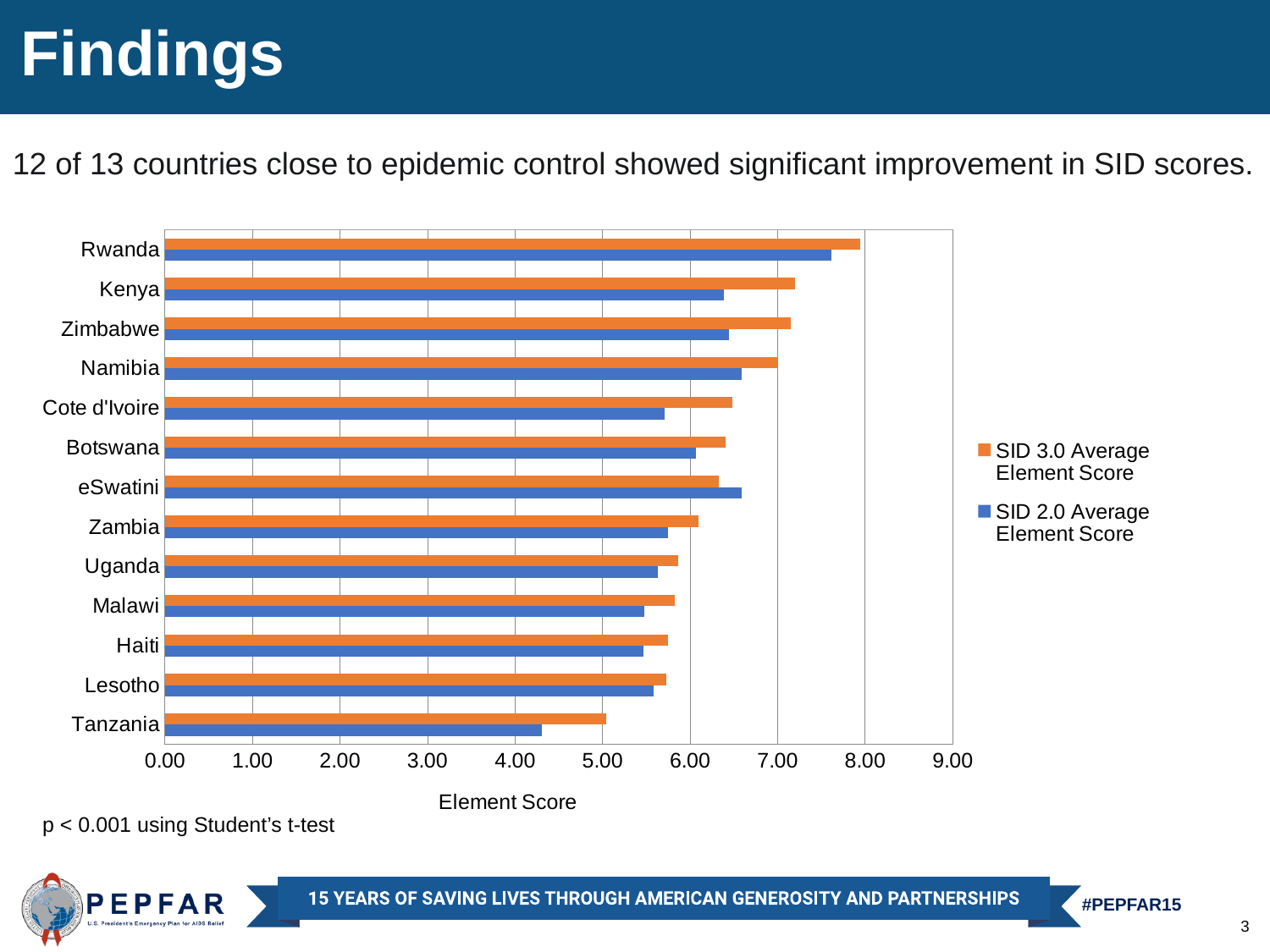
For Kenya, which is larger: the SID 3.0 Average Element Score or the SID 2.0 Average Element Score? SID 3.0 Average Element Score Which country has the lowest SID 2.0 Average Element Score? Tanzania How many countries are listed on the chart? 13 Which country has the lowest SID 3.0 Average Element Score? Tanzania Is the SID 2.0 Average Element Score for Cote d'Ivoire greater or less than 6.00? less How many series does the legend list? 2 Is the SID 3.0 Average Element Score for Rwanda greater or less than 7.00? greater Which country has the highest SID 3.0 Average Element Score? Rwanda Is the SID 2.0 Average Element Score for Tanzania greater or less than 5.00? less For eSwatini, which is larger: the SID 2.0 Average Element Score or the SID 3.0 Average Element Score? SID 2.0 Average Element Score What is the title of the horizontal axis? Element Score What kind of chart is shown on the slide? Bar chart